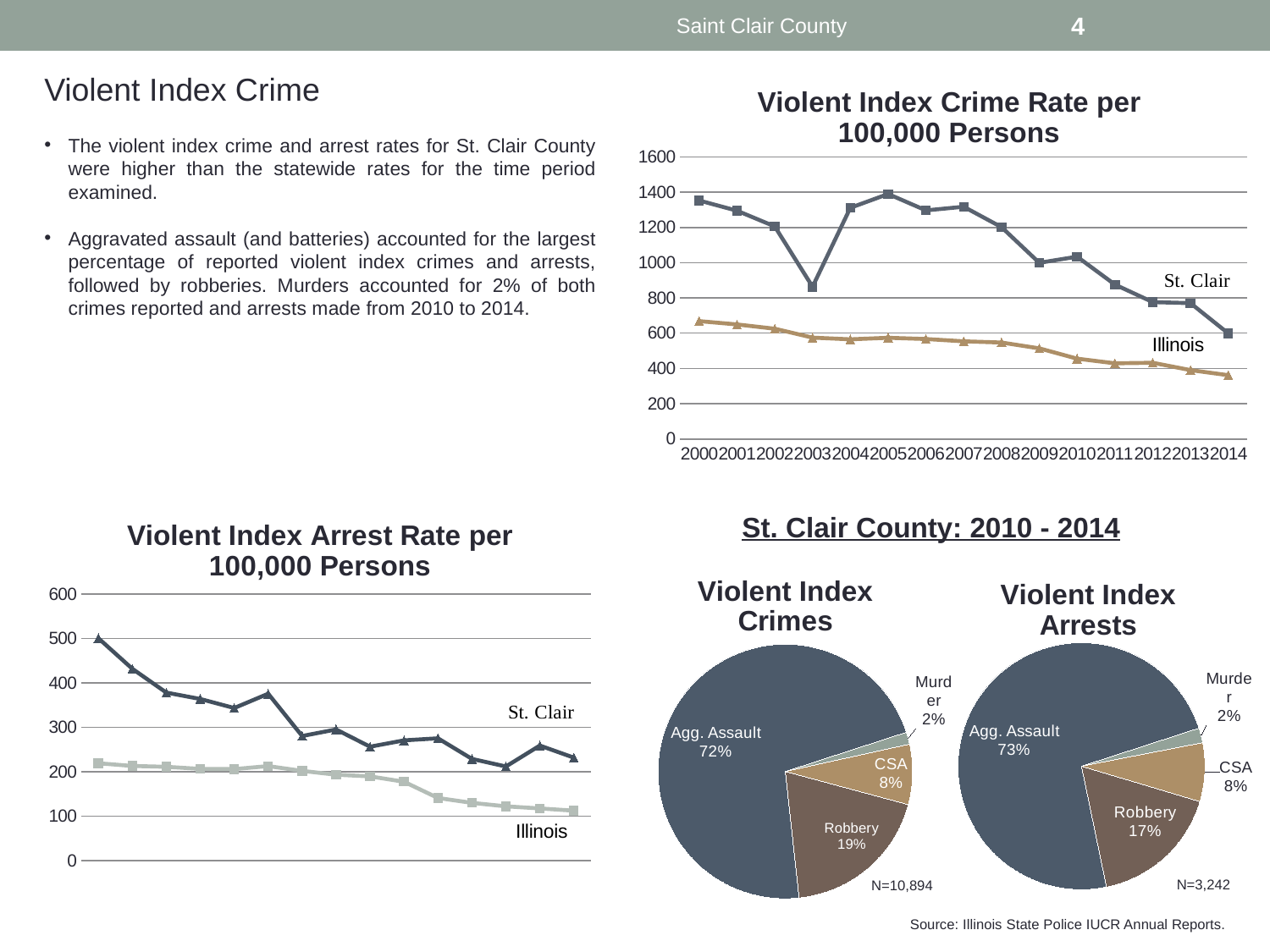
In the "Violent Index Crimes" pie chart, what share does Agg. Assault have? 72% In the "Violent Index Arrest Rate per 100,000 Persons" chart, is the Illinois value for 2014 greater or less than 200? less In the "Violent Index Arrests" pie chart, what share does Robbery have? 17% What kind of chart is the "Violent Index Crime Rate per 100,000 Persons" chart? line chart In the "Violent Index Crime Rate per 100,000 Persons" chart, does the Illinois line generally rise or fall from 2000 to 2014? fall What is the N value shown for the "Violent Index Crimes" pie chart? N=10,894 In the "Violent Index Arrests" pie chart, which category has the smallest slice? Murder In the "Violent Index Crime Rate per 100,000 Persons" chart, how many series are plotted? 2 In the "Violent Index Crimes" pie chart, what is the difference between the Robbery share and the CSA share? 11% In the "Violent Index Crime Rate per 100,000 Persons" chart, is the St. Clair value for 2014 greater or less than 800? less In the "Violent Index Crime Rate per 100,000 Persons" chart, how many years are shown on the x axis? 15 In the "Violent Index Arrest Rate per 100,000 Persons" chart, is the St. Clair value for 2000 greater or less than 400? greater